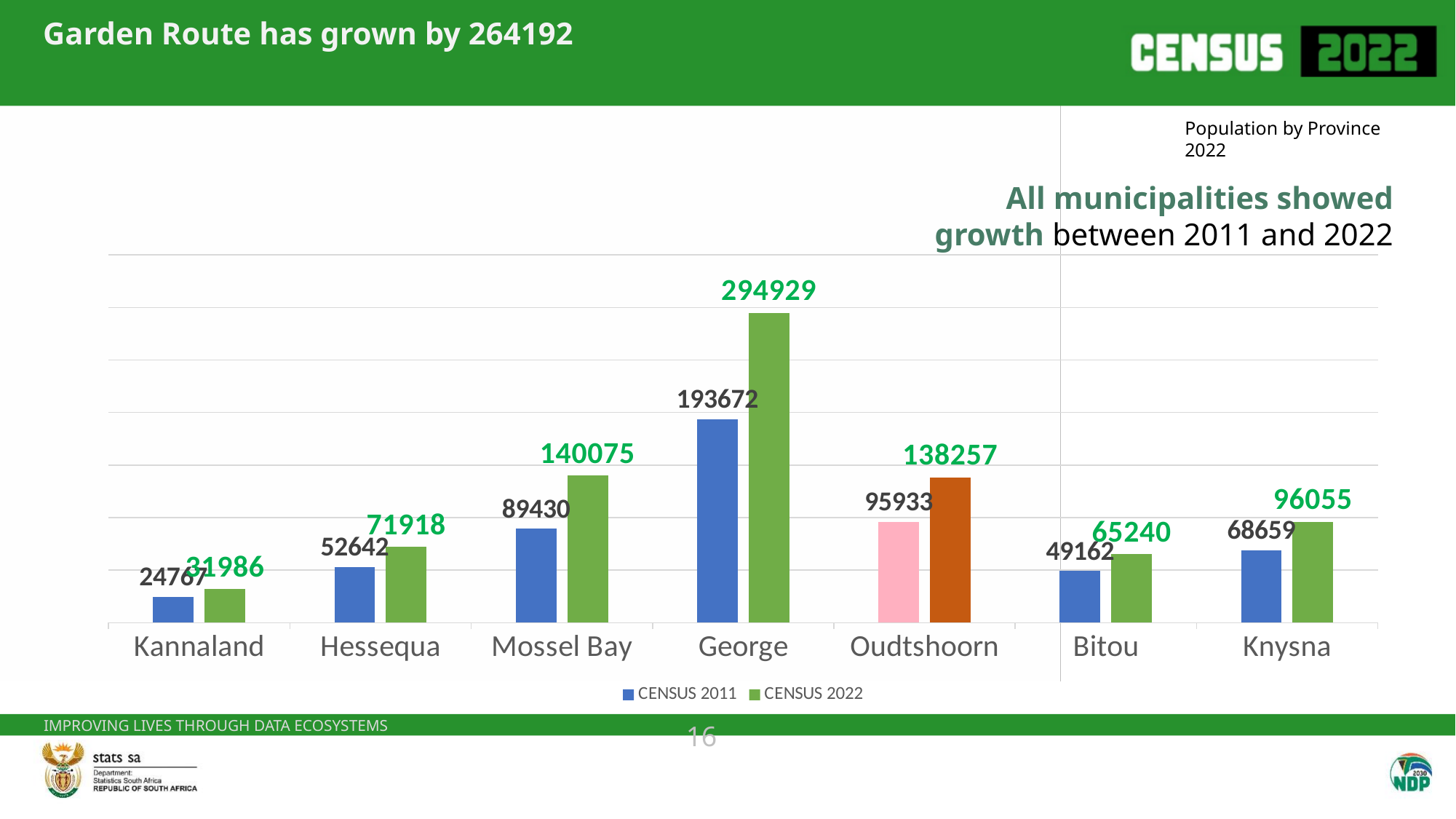
Which municipality had the highest population in Census 2022? George By how much did the population of Mossel Bay grow between Census 2011 and Census 2022? 50645 Which municipality's bars are shown in different colours (pink and orange) from the rest? Oudtshoorn Which had the larger Census 2011 population, Oudtshoorn or Mossel Bay? Oudtshoorn Which municipality had the lowest population in Census 2011? Kannaland How many municipalities are shown on the chart? 7 By how much did the population of George grow between Census 2011 and Census 2022? 101257 What kind of chart is shown on the slide? Bar chart What was the population of Mossel Bay in Census 2011? 89430 What was the population of Oudtshoorn in Census 2022? 138257 What was the population of George in Census 2022? 294929 How many series does the legend list? 2